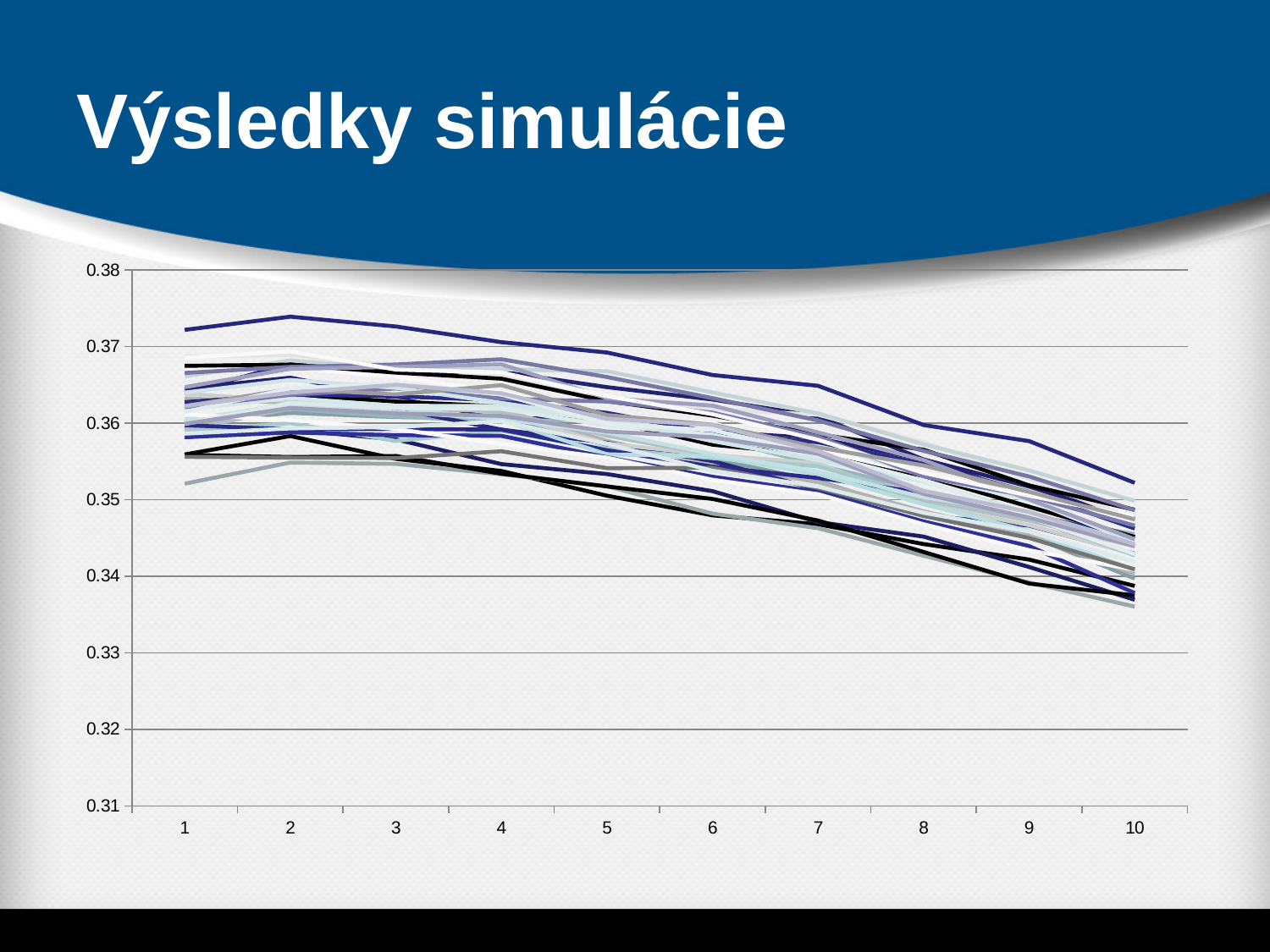
Are all plotted values at x = 1 greater or less than 0.35? greater What is the title of the slide containing the chart? Výsledky simulácie Is the value of the topmost line at x = 2 greater or less than 0.37? greater Is the value of the topmost line at x = 10 greater or less than 0.35? greater Do the plotted lines generally rise or fall from x = 1 to x = 10? fall What kind of chart is shown on the slide? line chart How many points are labelled along the x axis of the chart? 10 What is the lowest value shown on the y axis of the chart? 0.31